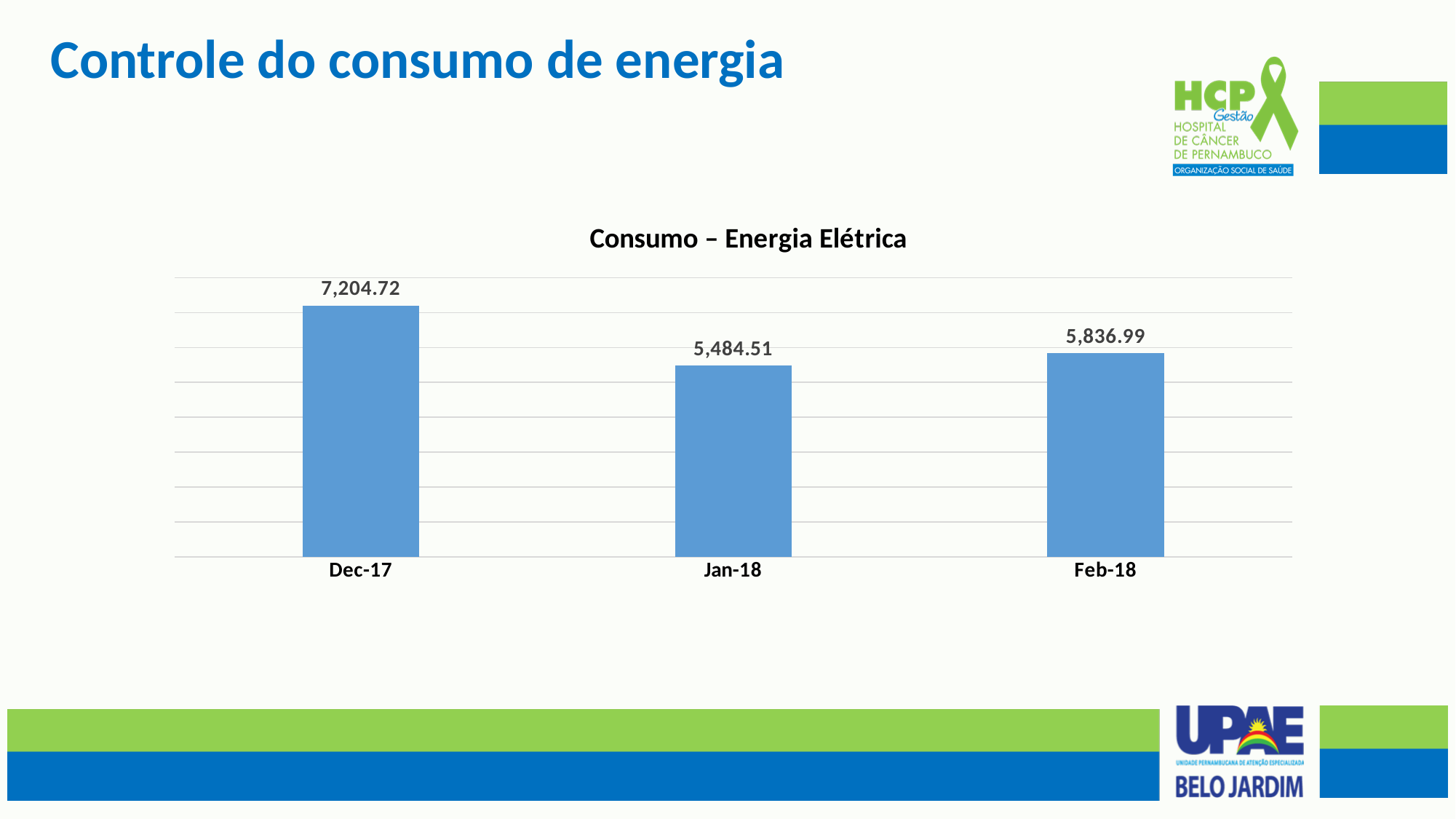
What is the difference between the values for Dec-17 and Jan-18? 1,720.21 What is the value for Dec-17? 7,204.72 What kind of chart is shown on the slide? Bar chart What is the value for Jan-18? 5,484.51 Which month has the highest consumption? Dec-17 What is the difference between the values for Feb-18 and Jan-18? 352.48 Which is larger, the value for Feb-18 or the value for Jan-18? Feb-18 Does the value rise or fall from Dec-17 to Jan-18? Fall Which month has the lowest consumption? Jan-18 What is the value for Feb-18? 5,836.99 What is the title of the chart? Consumo – Energia Elétrica How many months are shown on the chart? 3